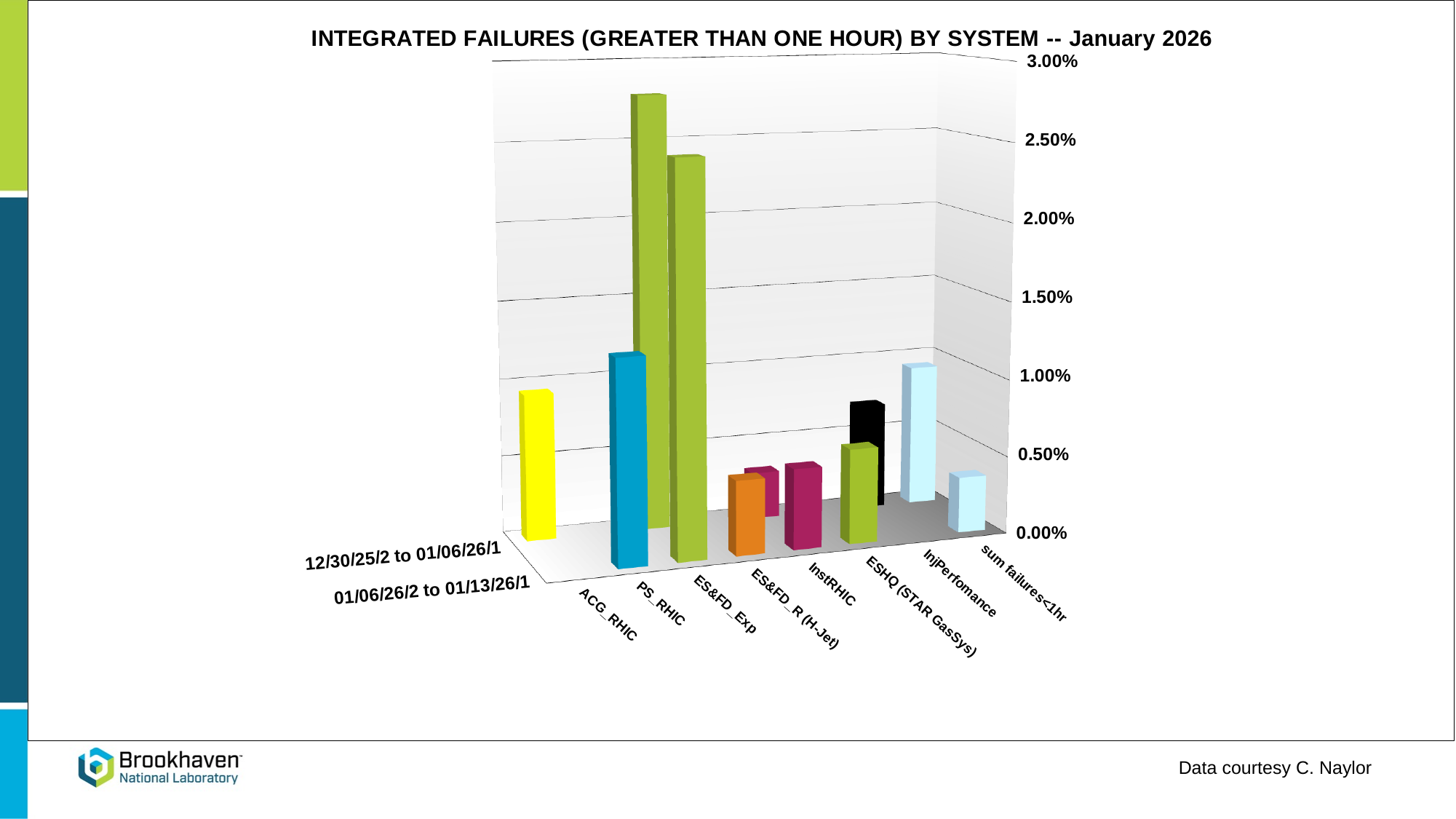
How many system categories are shown along the x axis? 8 What kind of chart is shown on the slide? bar chart How many time periods (rows) are plotted in the chart? 2 What is the highest value shown on the vertical axis? 3.00% Which is larger, the value for ES&FD_Exp or the value for ACG_RHIC? ES&FD_Exp Is the value for ACG_RHIC greater or less than 0.50%? greater Which is larger, the value for PS_RHIC or the value for sum failures<1hr? PS_RHIC Is the value for ES&FD_R (H-Jet) greater or less than 1.00%? less What is the title of the chart? INTEGRATED FAILURES (GREATER THAN ONE HOUR) BY SYSTEM -- January 2026 Which system has the tallest bar in the chart? ES&FD_Exp Is the tallest bar for ES&FD_Exp greater or less than 2.50%? greater